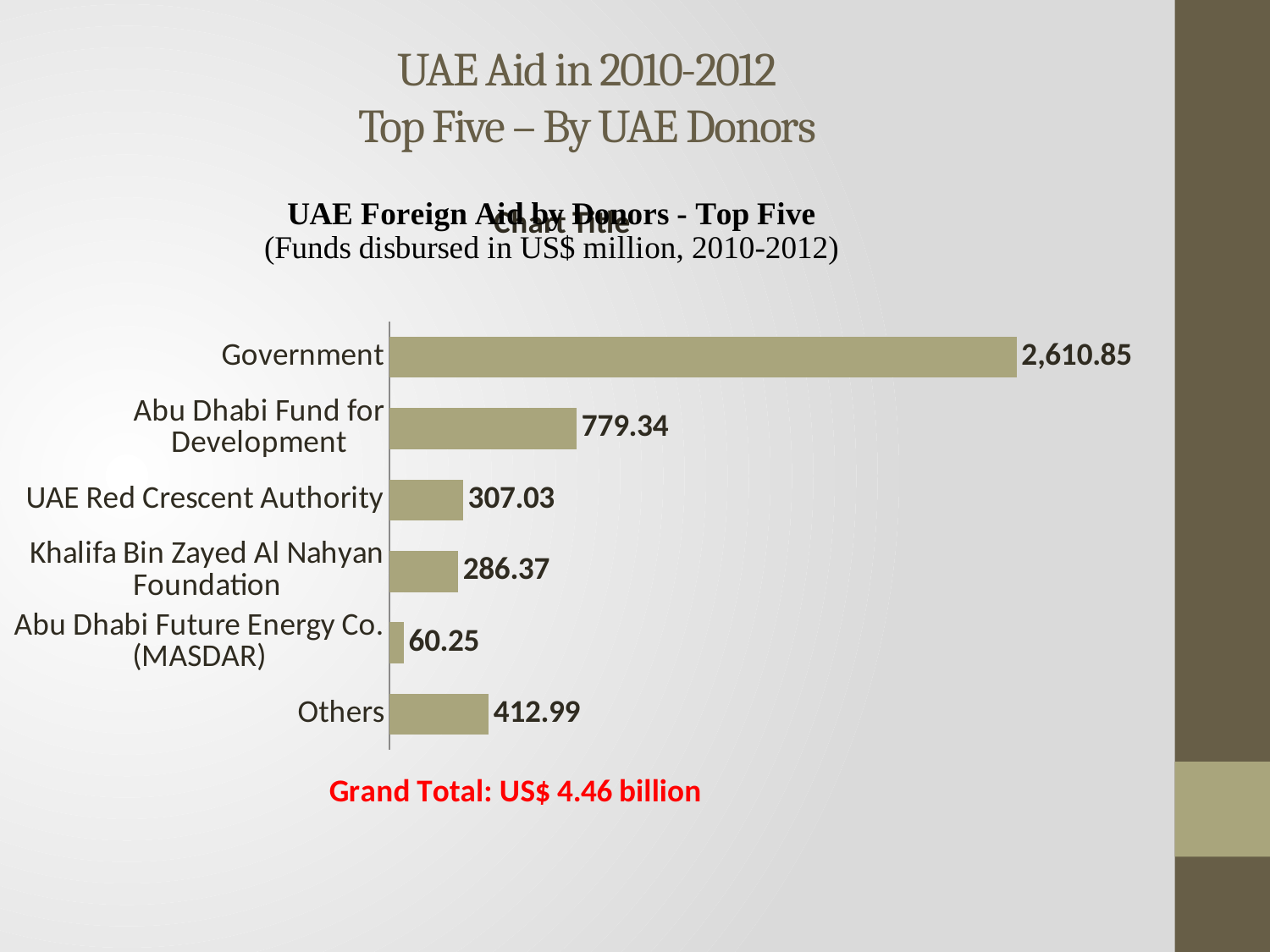
What is the value for Others? 412.99 What is the value for Abu Dhabi Fund for Development? 779.34 How many categories are shown in the chart? 6 What is the difference between the values for Government and Abu Dhabi Fund for Development? 1,831.51 What kind of chart is shown on the slide? Bar chart Which category has the highest value? Government What is the value for Khalifa Bin Zayed Al Nahyan Foundation? 286.37 Which category has the lowest value? Abu Dhabi Future Energy Co. (MASDAR) What is the value for Abu Dhabi Future Energy Co. (MASDAR)? 60.25 Which is larger, the value for Others or the value for UAE Red Crescent Authority? Others What is the value for UAE Red Crescent Authority? 307.03 What is the value for Government? 2,610.85